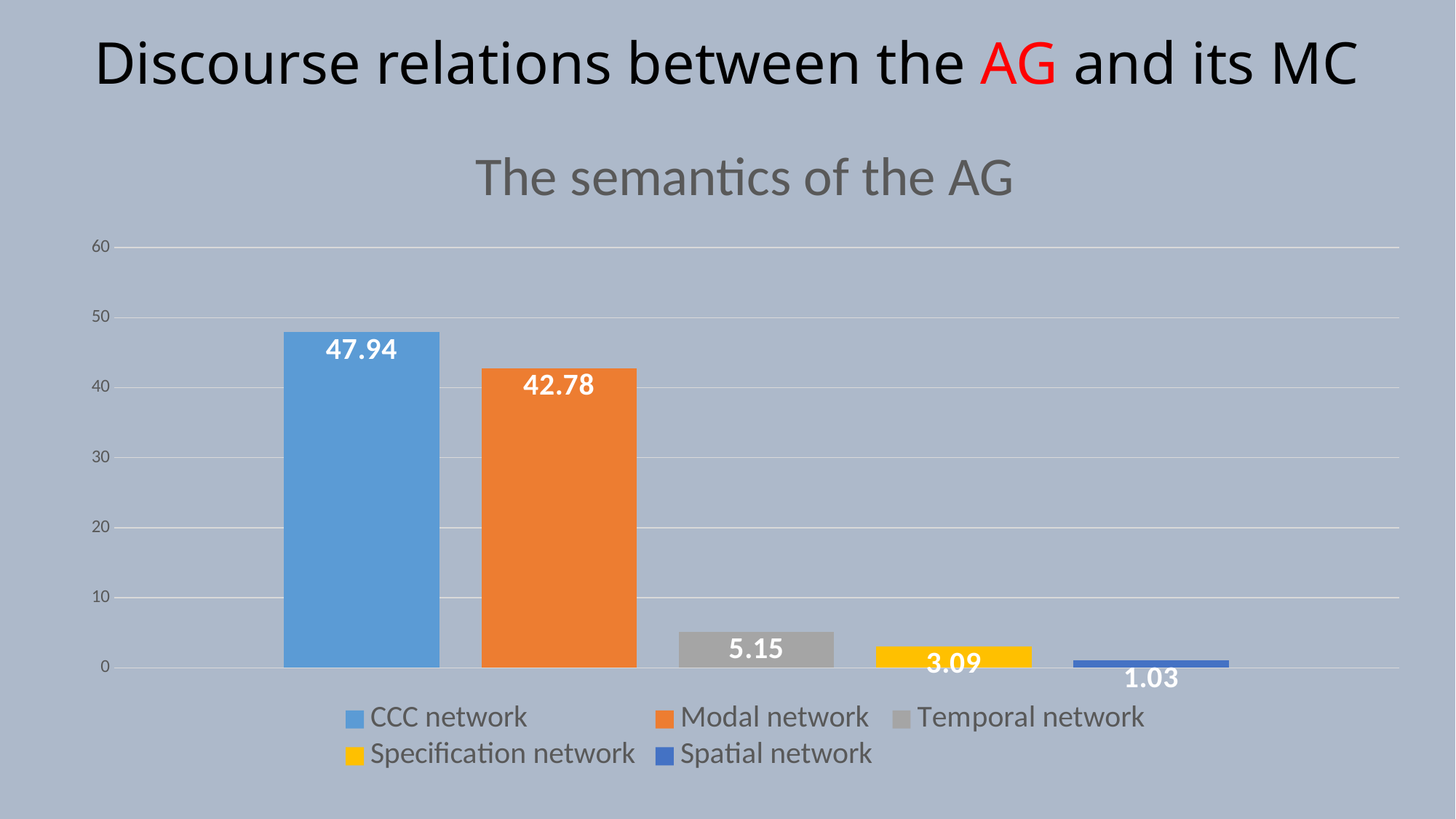
What is the title of the chart? The semantics of the AG Which is larger, the value for Temporal network or Specification network? Temporal network Is the value for Modal network greater or less than 40? greater Which network has the lowest value? Spatial network What is the value for Modal network? 42.78 What is the difference between the CCC network and Modal network values? 5.16 How many series does the legend list? 5 What is the value for Temporal network? 5.15 Which network has the highest value? CCC network What is the value for CCC network? 47.94 What kind of chart is shown on the slide? bar chart What is the value for Spatial network? 1.03